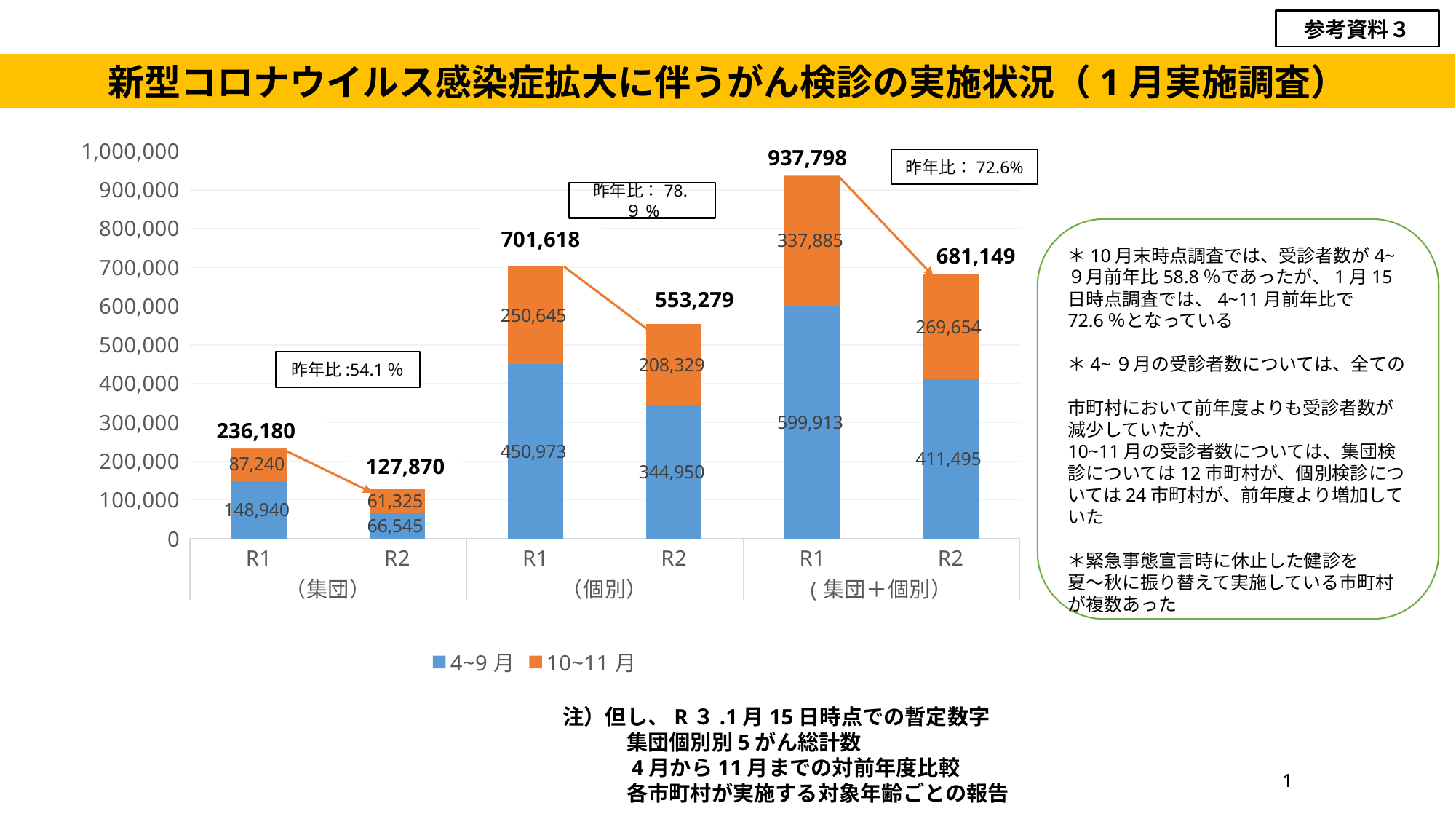
What is the total of the stacked bar for R2 in the 集団 group? 127,870 Which bar has the highest total value? R1 (集団＋個別) What is the 4~9月 value for R1 in the 集団 group? 148,940 What is the difference between the 4~9月 values for R1 and R2 in the 個別 group? 106,023 What is the total of the stacked bar for R1 in the 集団＋個別 group? 937,798 Which bar has the lowest total value? R2 (集団) Which is larger: the 10~11月 value for R1 in the 集団＋個別 group or the 10~11月 value for R2 in the same group? R1 (337,885) What is the 10~11月 value for R2 in the 個別 group? 208,329 What kind of chart is shown on the slide? Stacked bar chart What 昨年比 percentage is shown for the 個別 group? 78.9% How many bars are plotted in the chart? 6 How many series does the legend list? 2